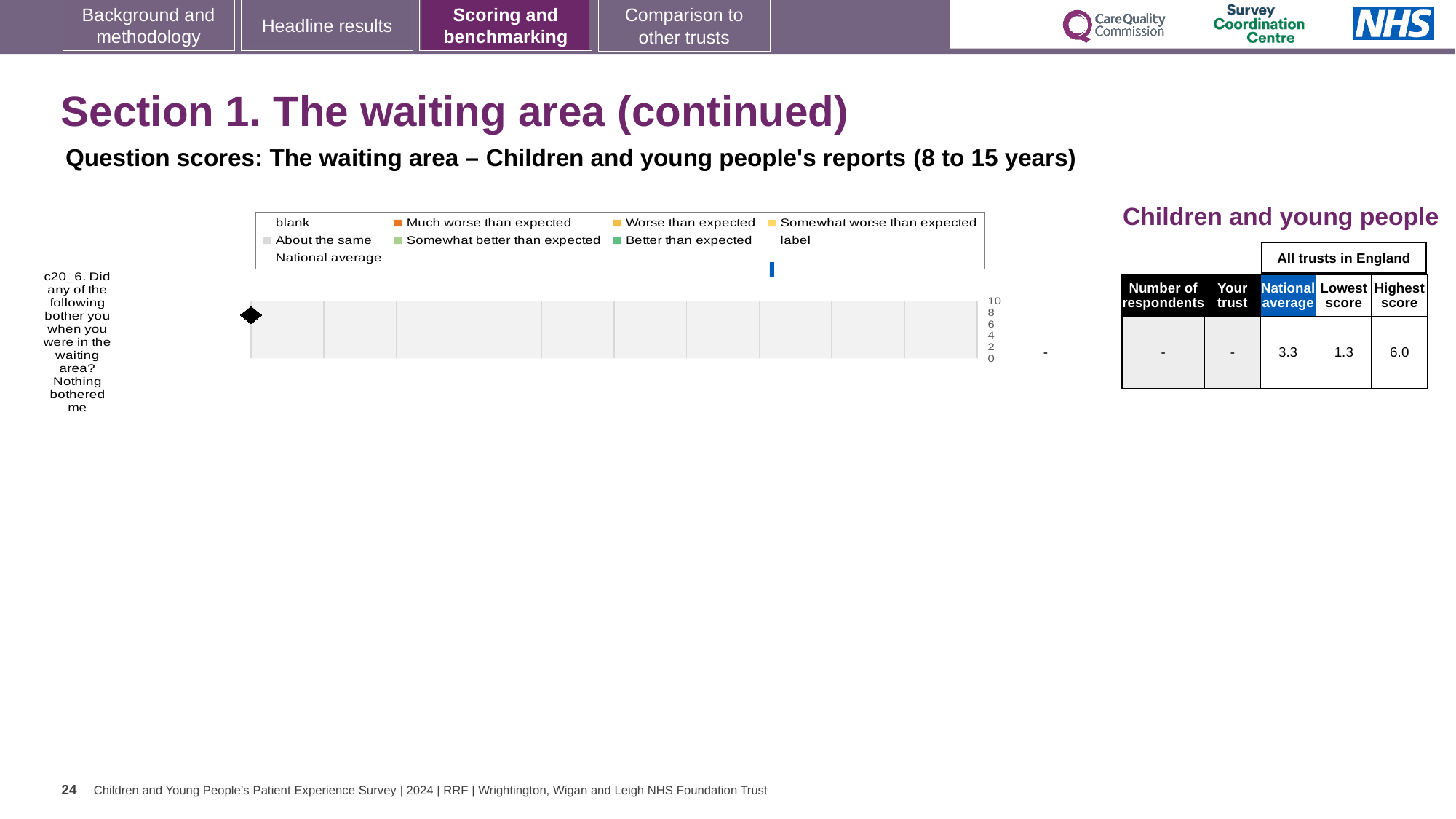
What is the difference between the highest score and the lowest score for question c20_6? 4.7 What kind of chart is shown on the slide? bar chart What is the highest value shown on the chart's value axis? 10 How many question categories are plotted on the chart? 1 What is the lowest score across all trusts in England for question c20_6? 1.3 What is the highest score across all trusts in England for question c20_6? 6.0 What value is shown for 'Your trust' for question c20_6 on the slide? - What is the question label shown on the chart's category axis? c20_6. Did any of the following bother you when you were in the waiting area? Nothing bothered me What colour does the legend use for 'Much worse than expected'? orange What is the national average score for question c20_6 shown on the slide? 3.3